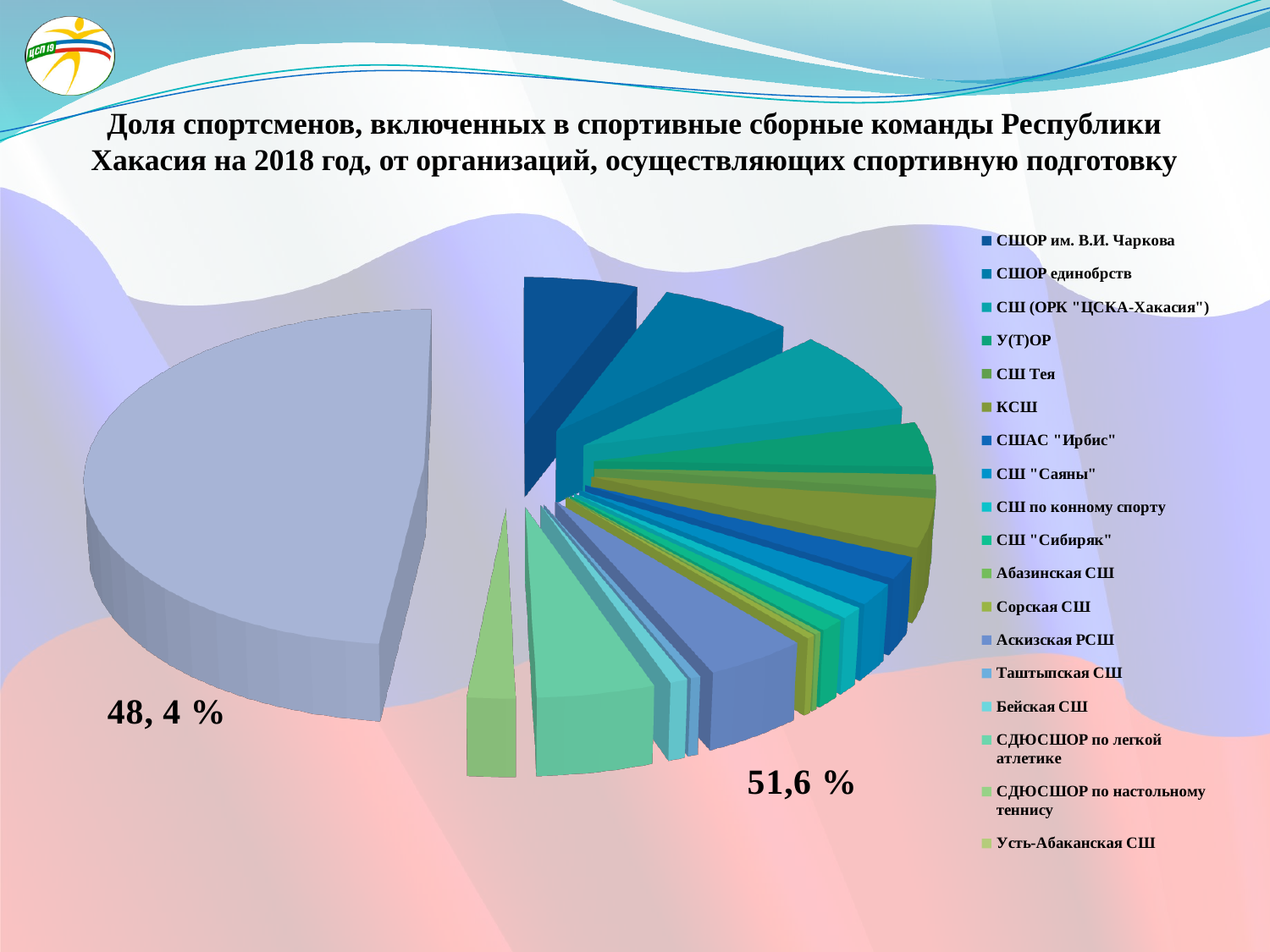
What is the last entry listed in the legend of the pie chart? Усть-Абаканская СШ What is the first entry listed in the legend of the pie chart? СШОР им. В.И. Чаркова What kind of chart is shown on the slide? pie chart What percentage label is printed next to the large separated slice on the left of the pie chart? 48, 4 % Which of the two percentage labels on the pie chart is larger, 48, 4 % or 51,6 %? 51,6 % What do the two percentage labels on the pie chart, 48, 4 % and 51,6 %, add up to? 100 % What is the difference between the two percentage labels shown on the pie chart, 51,6 % and 48, 4 %? 3,2 % What percentage label is printed below the group of smaller slices on the right of the pie chart? 51,6 % How many categories does the legend of the pie chart list? 18